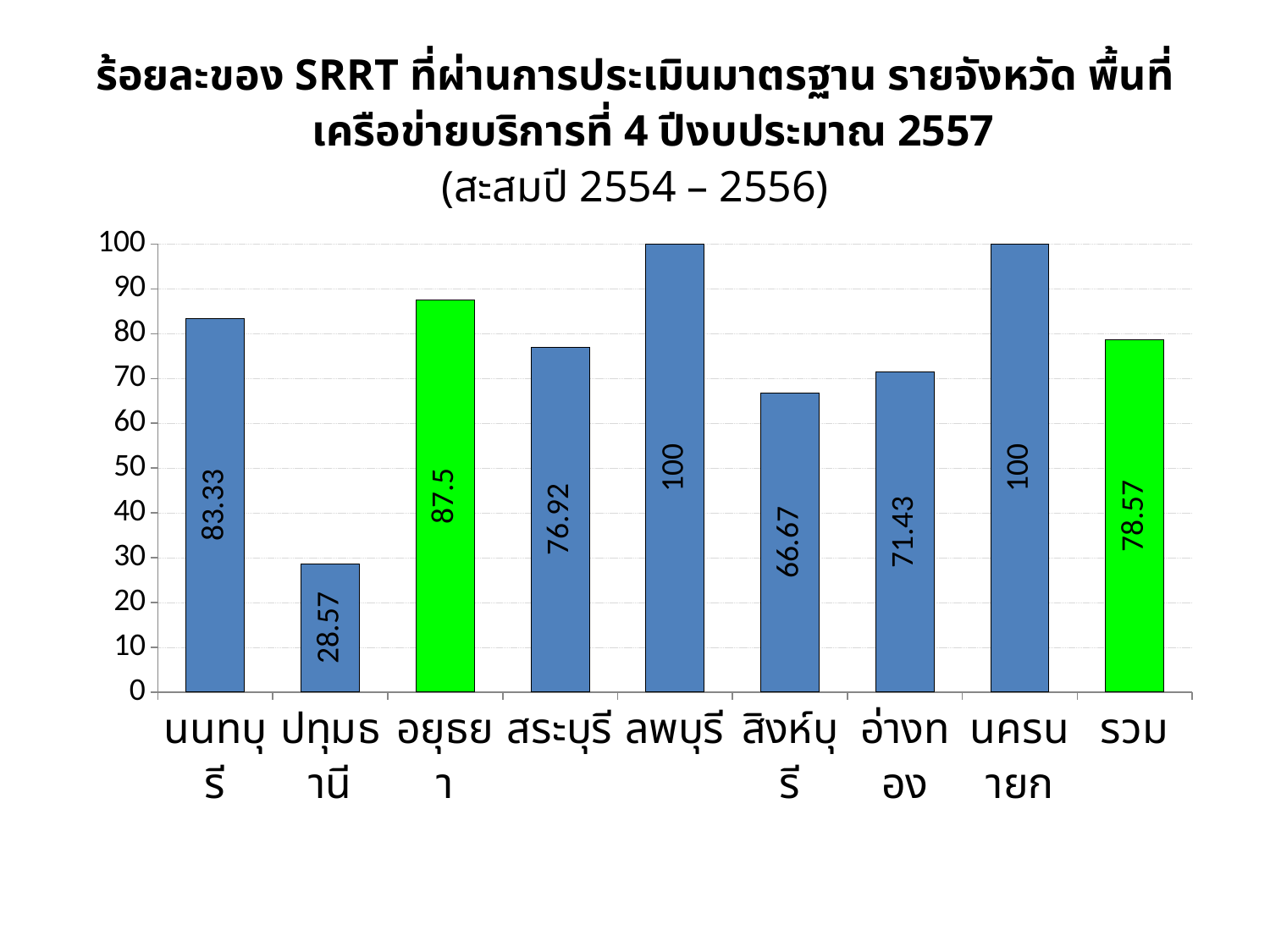
What is the value for ปทุมธานี? 28.57 Which is larger, the value for อ่างทอง or the value for สิงห์บุรี? อ่างทอง What is the highest value shown on the chart? 100 Which two bars are coloured green? อยุธยา and รวม What is the value for อยุธยา? 87.5 What is the value for สิงห์บุรี? 66.67 What kind of chart is shown on the slide? Bar chart What is the value for นนทบุรี? 83.33 How many bars are shown on the chart? 9 Which province has the lowest value? ปทุมธานี What is the difference between the values for อยุธยา and สระบุรี? 10.58 What is the value for รวม? 78.57